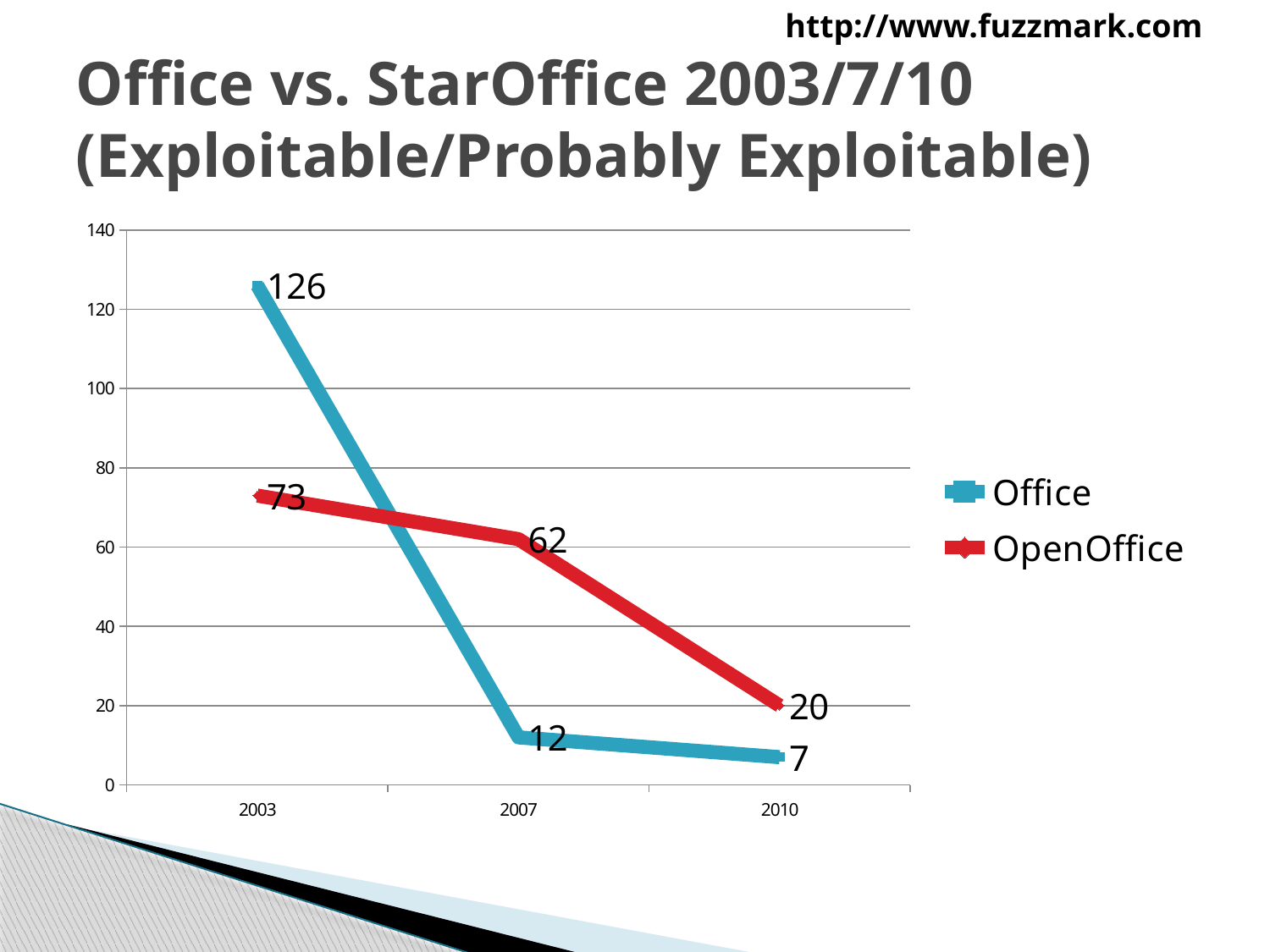
How many series does the legend list? 2 What is the value for OpenOffice in 2010? 20 What is the difference between the Office and OpenOffice values in 2003? 53 Which series has the larger value in 2007, Office or OpenOffice? OpenOffice What is the value for Office in 2003? 126 What is the value for Office in 2010? 7 What kind of chart is shown on the slide? Line chart What is the value for OpenOffice in 2007? 62 Do the Office values rise or fall from 2003 to 2010? Fall In which year is the Office series highest? 2003 In which year is the OpenOffice series lowest? 2010 How many years are shown on the x axis? 3